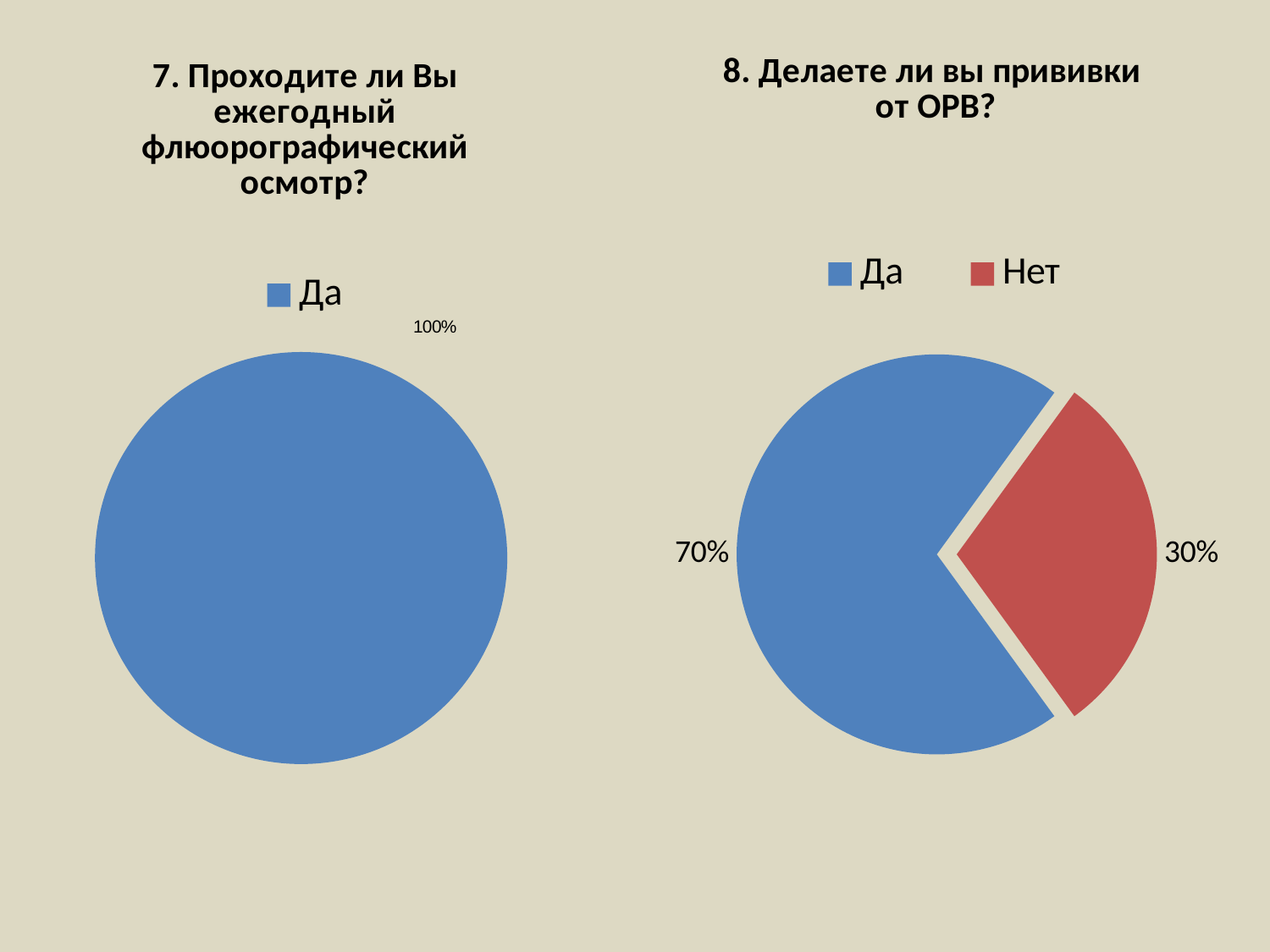
In the right chart (question 8), which slice is the smallest? Нет In the right chart (question 8), how many entries does the legend list? 2 In the right chart (question 8), what is the difference between the "Да" and "Нет" shares? 40% In the left chart (question 7, annual fluorography check-up), what share is labelled for "Да"? 100% In the right chart (question 8), which is larger: "Да" or "Нет"? Да In the right chart (question 8), what share is labelled for "Нет"? 30% In the right chart (question 8), which slice is the largest? Да In the right chart (question 8, vaccination against ОРВ), what share is labelled for "Да"? 70% In the right chart (question 8), what colour is the "Нет" slice? Red In the left chart (question 7), how many legend entries are shown? 1 In the right chart (question 8), how many slices does the pie have? 2 What kind of chart is the left chart (question 7)? Pie chart